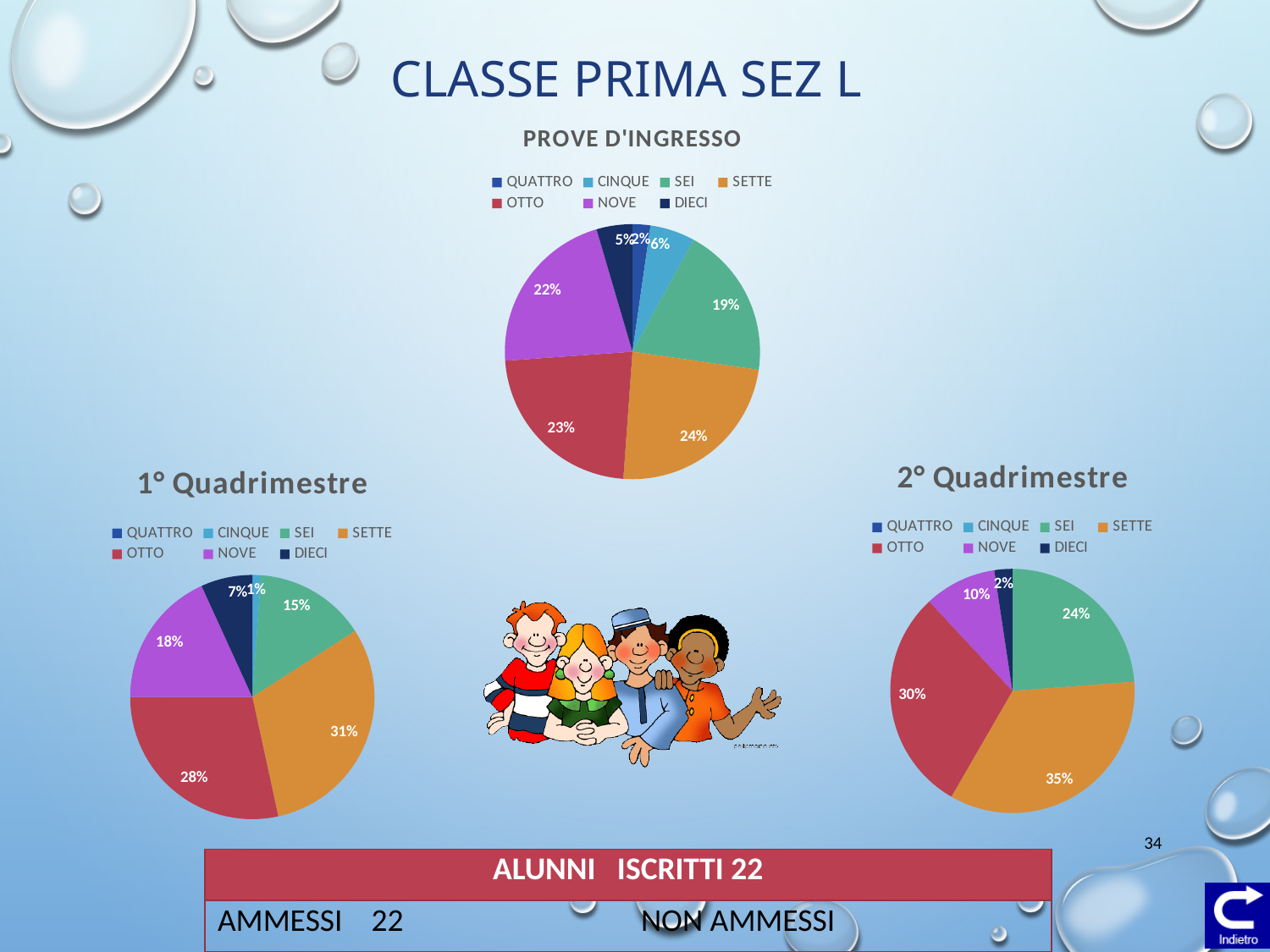
In the PROVE D'INGRESSO chart, what percentage is shown for NOVE? 22% In the 2° Quadrimestre chart, what is the difference between the SETTE and OTTO slices? 5% In the PROVE D'INGRESSO chart, what is the difference between the SEI and OTTO slices? 4% How many entries does the legend of the 2° Quadrimestre chart list? 7 In the 1° Quadrimestre chart, what percentage is shown for SETTE? 31% In the 1° Quadrimestre chart, which is larger, the OTTO slice or the SEI slice? OTTO In the PROVE D'INGRESSO chart, what percentage is shown for SETTE? 24% In the 1° Quadrimestre chart, what percentage is shown for NOVE? 18% What type of chart is used for the 1° Quadrimestre data? Pie chart In the 1° Quadrimestre chart, which grade has the smallest slice? CINQUE In the PROVE D'INGRESSO chart, which grade has the largest slice? SETTE In the 2° Quadrimestre chart, what percentage is shown for SETTE? 35%